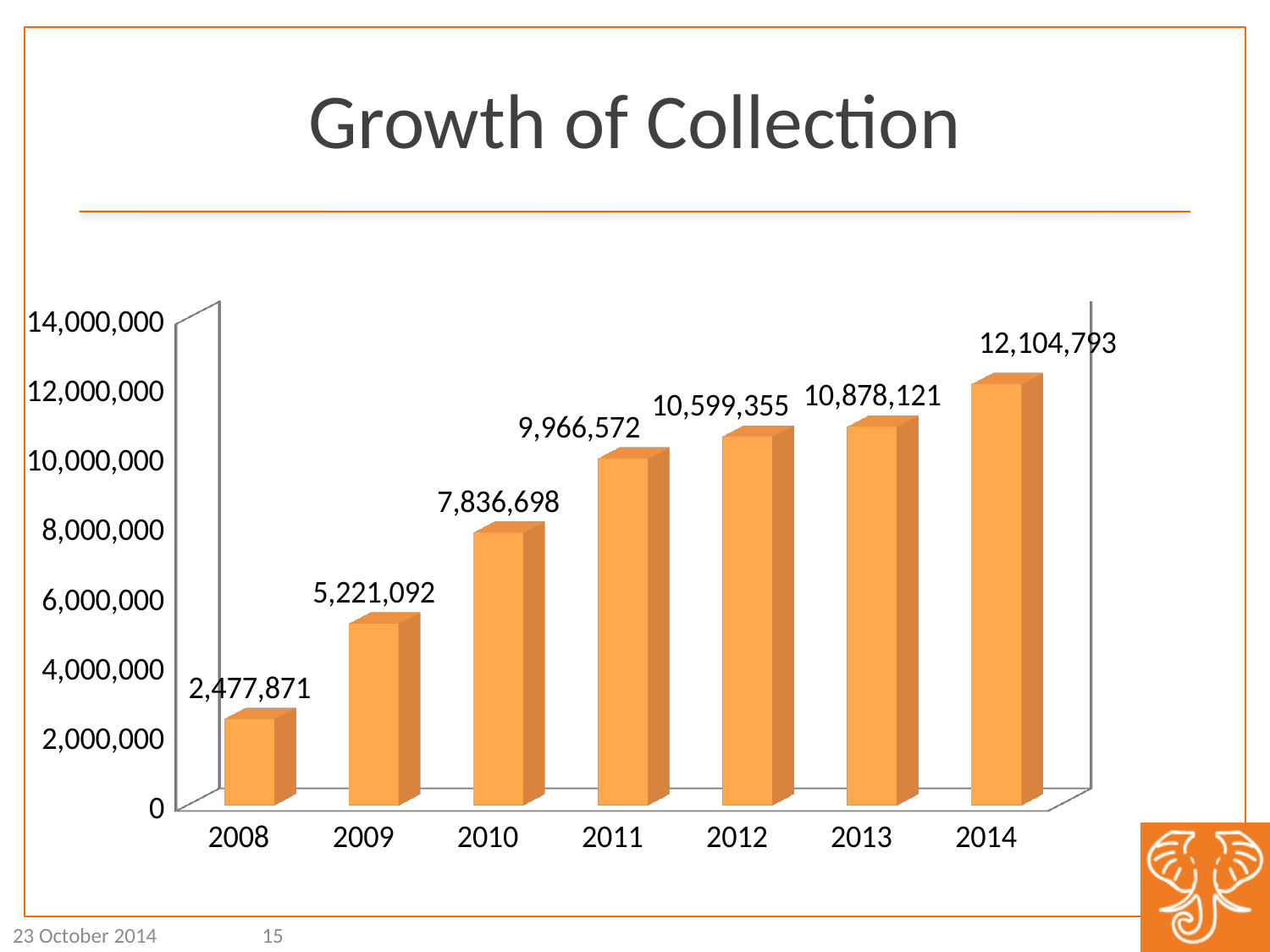
How many years are shown on the x axis? 7 Do the values rise or fall from 2008 to 2014? rise What kind of chart is shown on the slide? bar chart What is the difference between the values for 2014 and 2008? 9,626,922 Which is larger, the value for 2010 or the value for 2012? 2012 Is the value for 2011 greater or less than 8,000,000? greater Which year has the lowest value? 2008 What is the value for 2011? 9,966,572 What is the difference between the values for 2013 and 2012? 278,766 What is the value for 2014? 12,104,793 Which year has the highest value? 2014 What is the value for 2008? 2,477,871